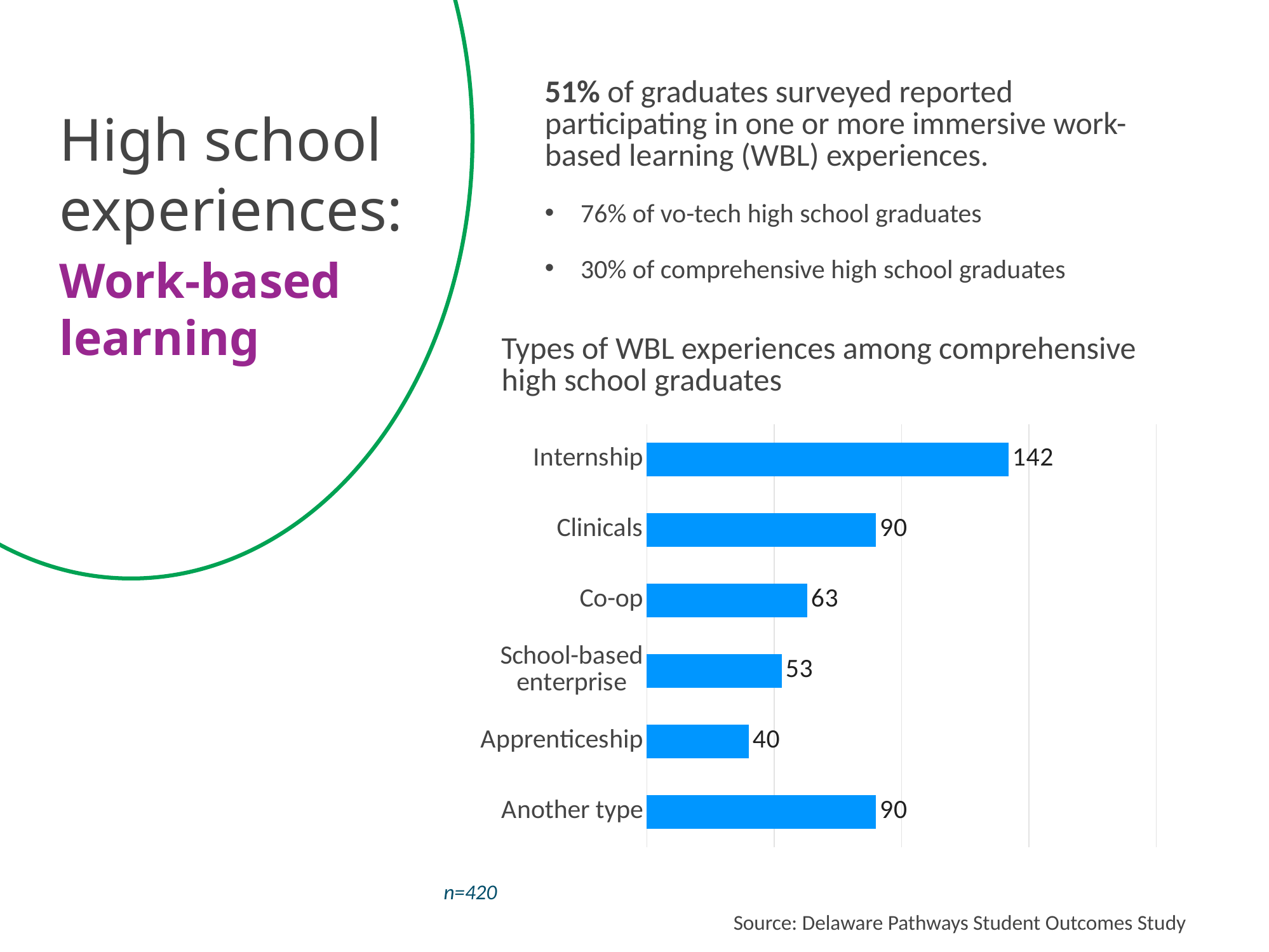
Which category has the highest value? Internship What is the value for School-based enterprise? 53 How many categories are shown in the chart? 6 What is the difference between the values for Co-op and Apprenticeship? 23 Which category has the lowest value? Apprenticeship What is the value for Apprenticeship? 40 What is the difference between the values for Internship and Clinicals? 52 What is the value for Internship? 142 Which is larger, the value for Co-op or the value for School-based enterprise? Co-op What is the value for Co-op? 63 What is the title of the chart? Types of WBL experiences among comprehensive high school graduates What kind of chart is shown on the slide? Bar chart